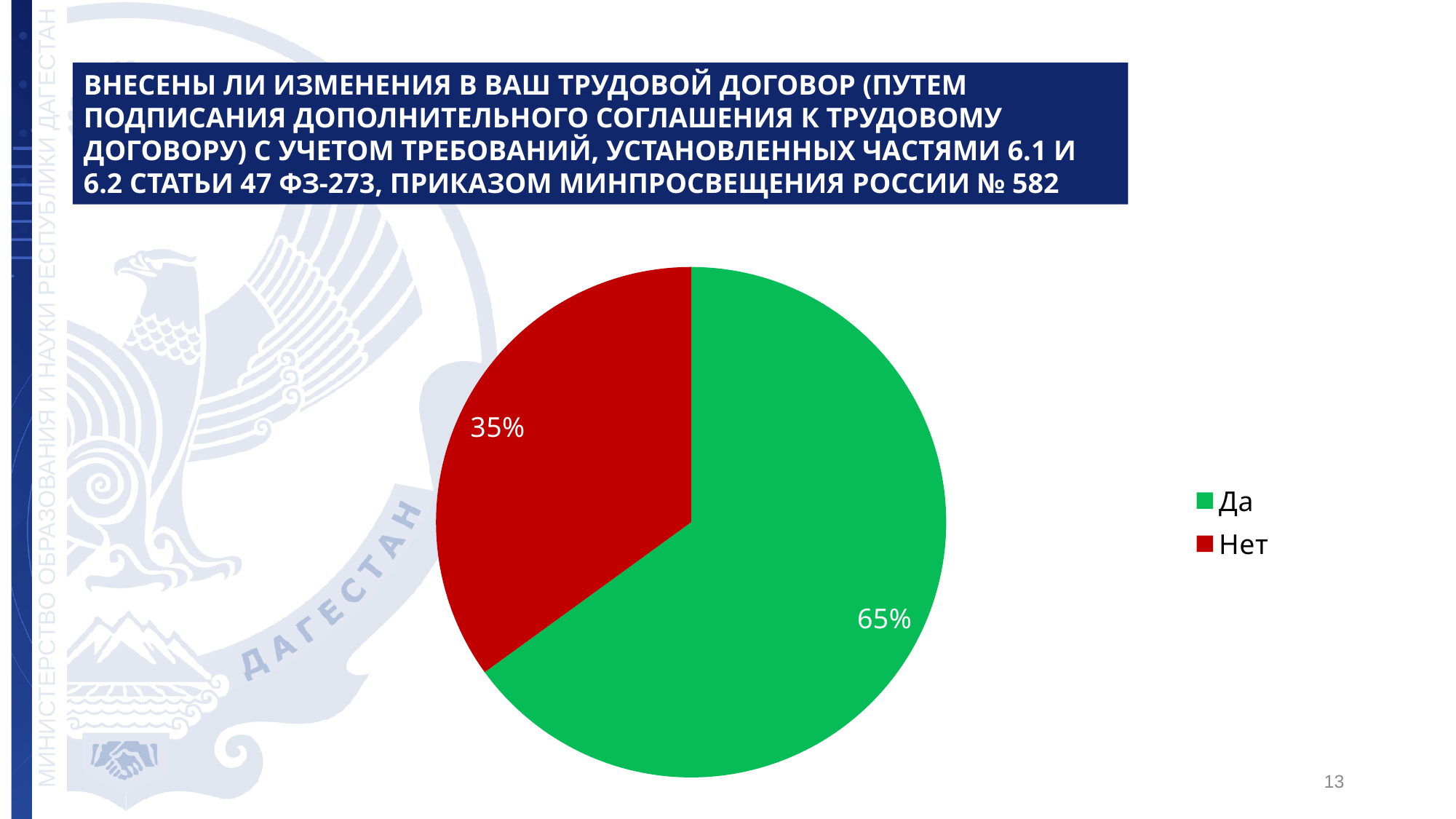
Which answer has the smallest share of the pie? Нет What share of the pie does the "Нет" slice represent? 35% How many entries does the legend list? 2 How many slices does the pie chart have? 2 Which slice is larger, "Да" or "Нет"? Да What is the difference in percentage points between the "Да" and "Нет" slices? 30 What colour is the "Нет" slice? red Which answer has the largest share of the pie? Да What percentage of respondents answered "Нет"? 35% What kind of chart is shown on the slide? pie chart What colour is the "Да" slice? green What percentage of respondents answered "Да"? 65%